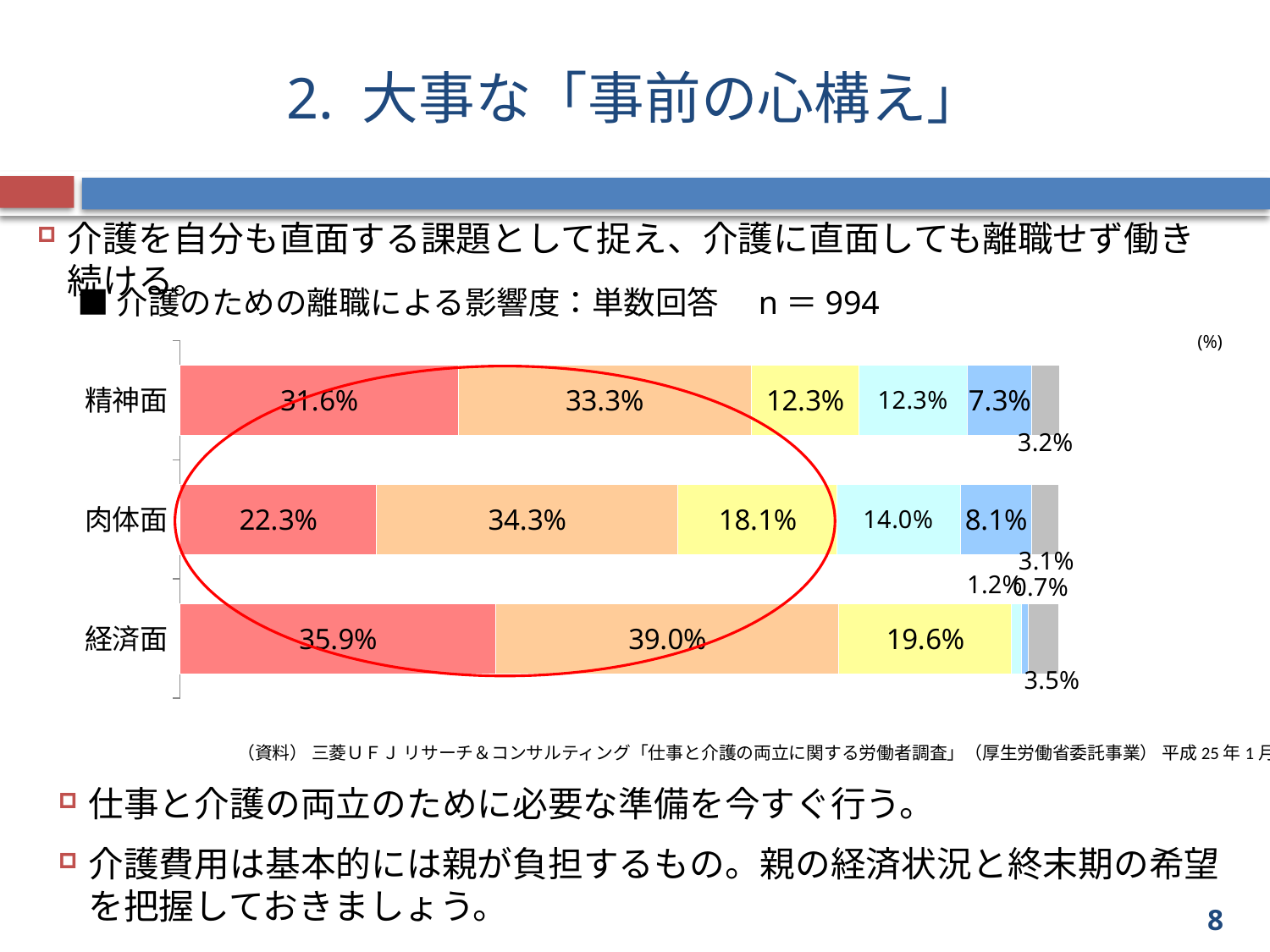
Which category has the smallest yellow segment? 精神面 How many categories are plotted on the vertical axis of the chart? 3 What is the value of the light blue segment for 精神面? 12.3% What is the sample size (n) stated in the chart heading? 994 Which category has the largest first (red) segment? 経済面 What is the difference between the red segment of 経済面 and the red segment of 精神面? 4.3 percentage points What is the value of the second (orange) segment for 肉体面? 34.3% What is the combined value of the red and orange segments for 経済面? 74.9% Which is larger, the yellow segment for 肉体面 or the yellow segment for 精神面? 肉体面 What kind of chart is shown on the slide? Stacked bar chart What is the value of the first (red) segment for 経済面? 35.9% What is the value of the gray segment at the end of the 経済面 bar? 3.5%